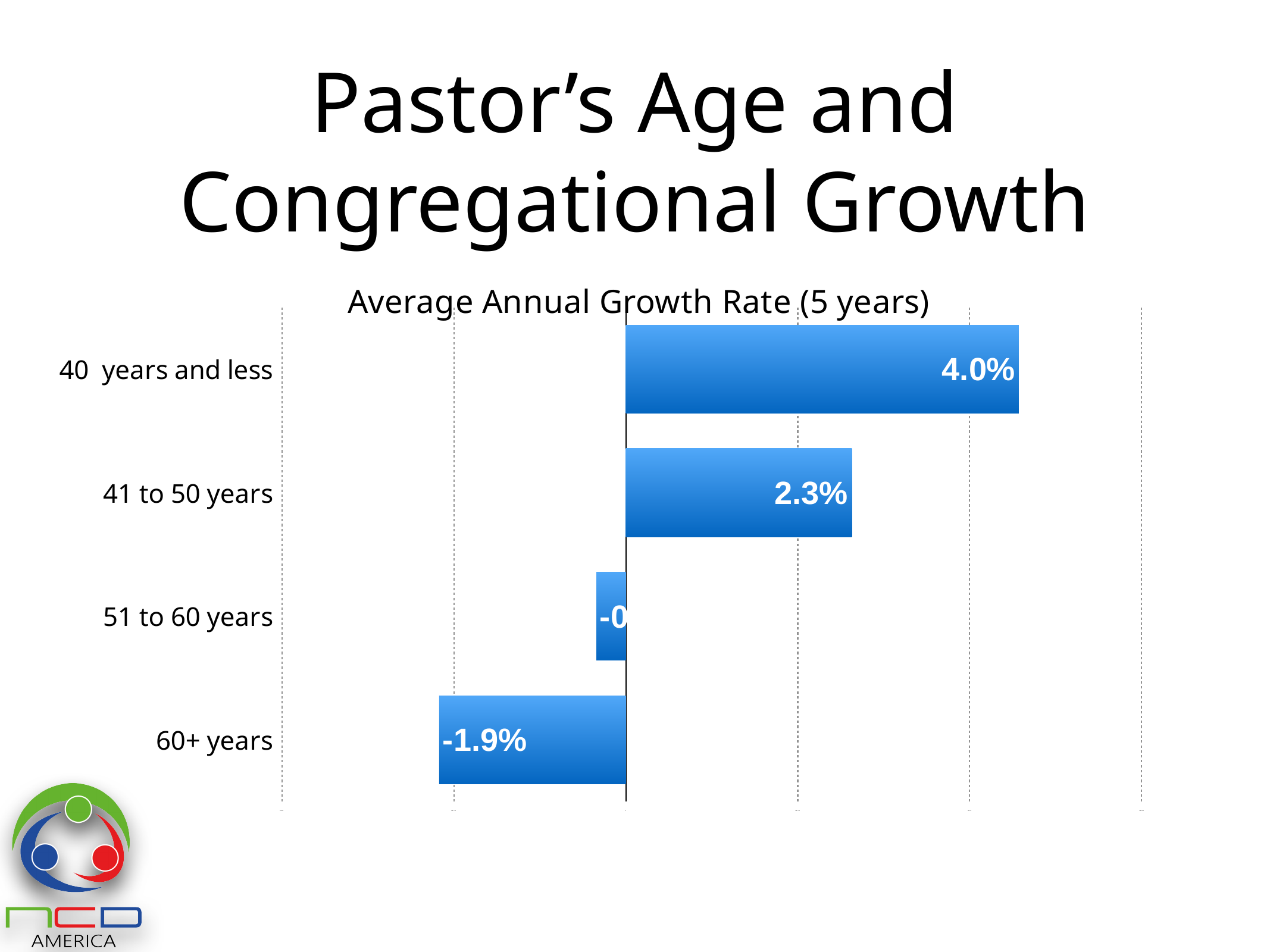
How many pastor age groups are shown in the chart? 4 What is the difference between the growth rate for 41 to 50 years and the growth rate for 60+ years? 4.2 percentage points What is the average annual growth rate for pastors aged 60+ years? -1.9% Which pastor age group has the lowest average annual growth rate? 60+ years Which has the larger growth rate, 41 to 50 years or 60+ years? 41 to 50 years As the pastor's age group increases from top to bottom, does the average annual growth rate rise or fall? Fall What kind of chart is shown on the slide? Bar chart What is the average annual growth rate for pastors aged 40 years and less? 4.0% Which pastor age group has the highest average annual growth rate? 40 years and less What is the title of the chart? Average Annual Growth Rate (5 years) What is the difference between the growth rate for 40 years and less and the growth rate for 41 to 50 years? 1.7 percentage points What is the average annual growth rate for pastors aged 41 to 50 years? 2.3%